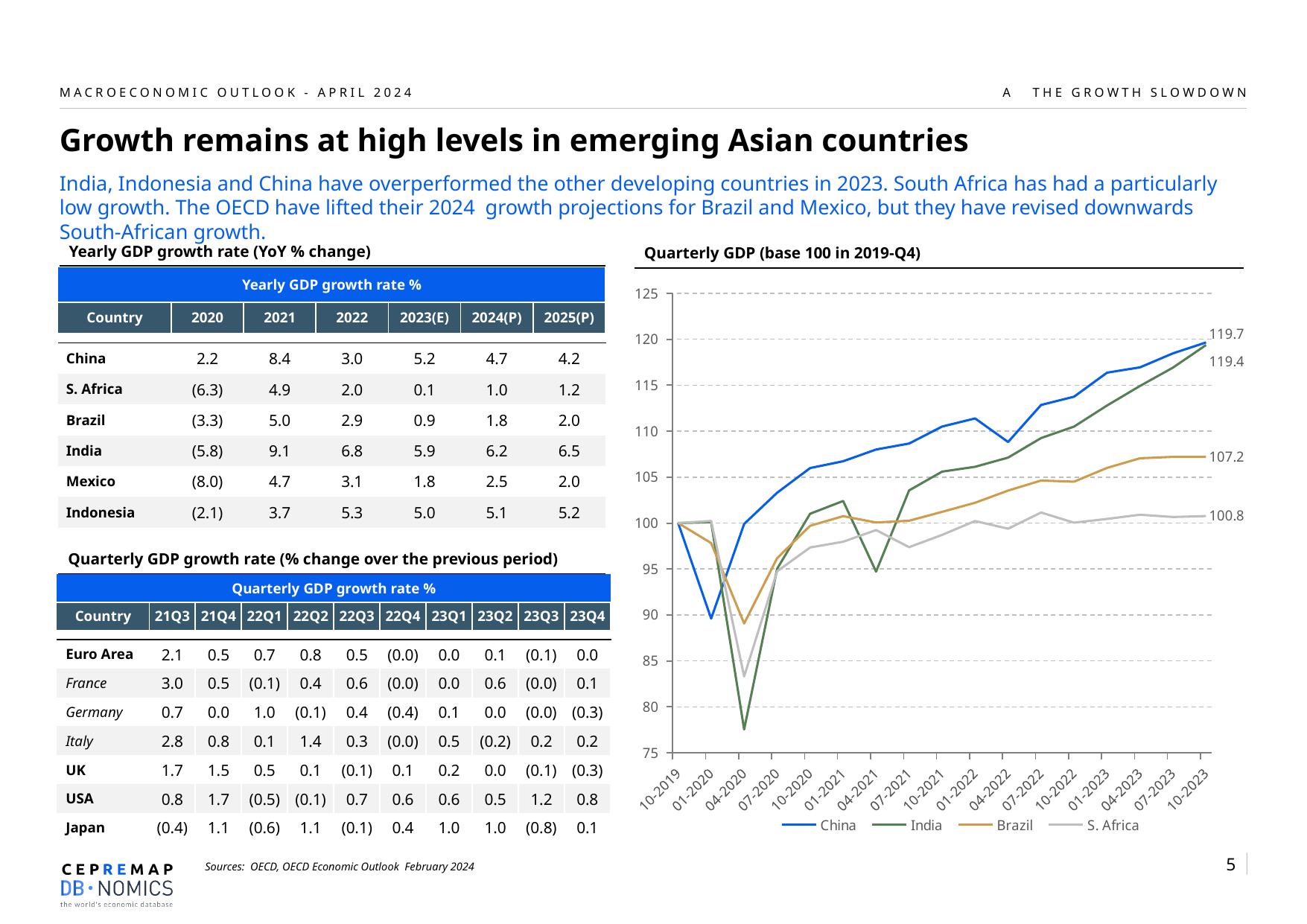
In the Quarterly GDP chart, what is the value labelled for India at 10-2023? 119.4 In the Quarterly GDP chart, what is the value labelled for S. Africa at 10-2023? 100.8 How many quarterly labels are shown on the x axis of the Quarterly GDP chart? 17 What kind of chart is the 'Quarterly GDP (base 100 in 2019-Q4)' chart? line chart In the Quarterly GDP chart, what is the difference between the China and Brazil values at 10-2023? 12.5 In the Quarterly GDP chart, is the value for India at 04-2020 greater or less than 80? less In the Quarterly GDP chart, what is the value labelled for Brazil at 10-2023? 107.2 In the Quarterly GDP chart, does the Brazil line rise or fall overall from 07-2020 to 10-2023? rise In the Quarterly GDP chart, what is the value labelled for China at 10-2023? 119.7 How many series does the legend of the Quarterly GDP chart list? 4 In the Quarterly GDP chart, which country has the lowest value at 10-2023? S. Africa In the Quarterly GDP chart, is the value for S. Africa at 04-2020 greater or less than 85? less